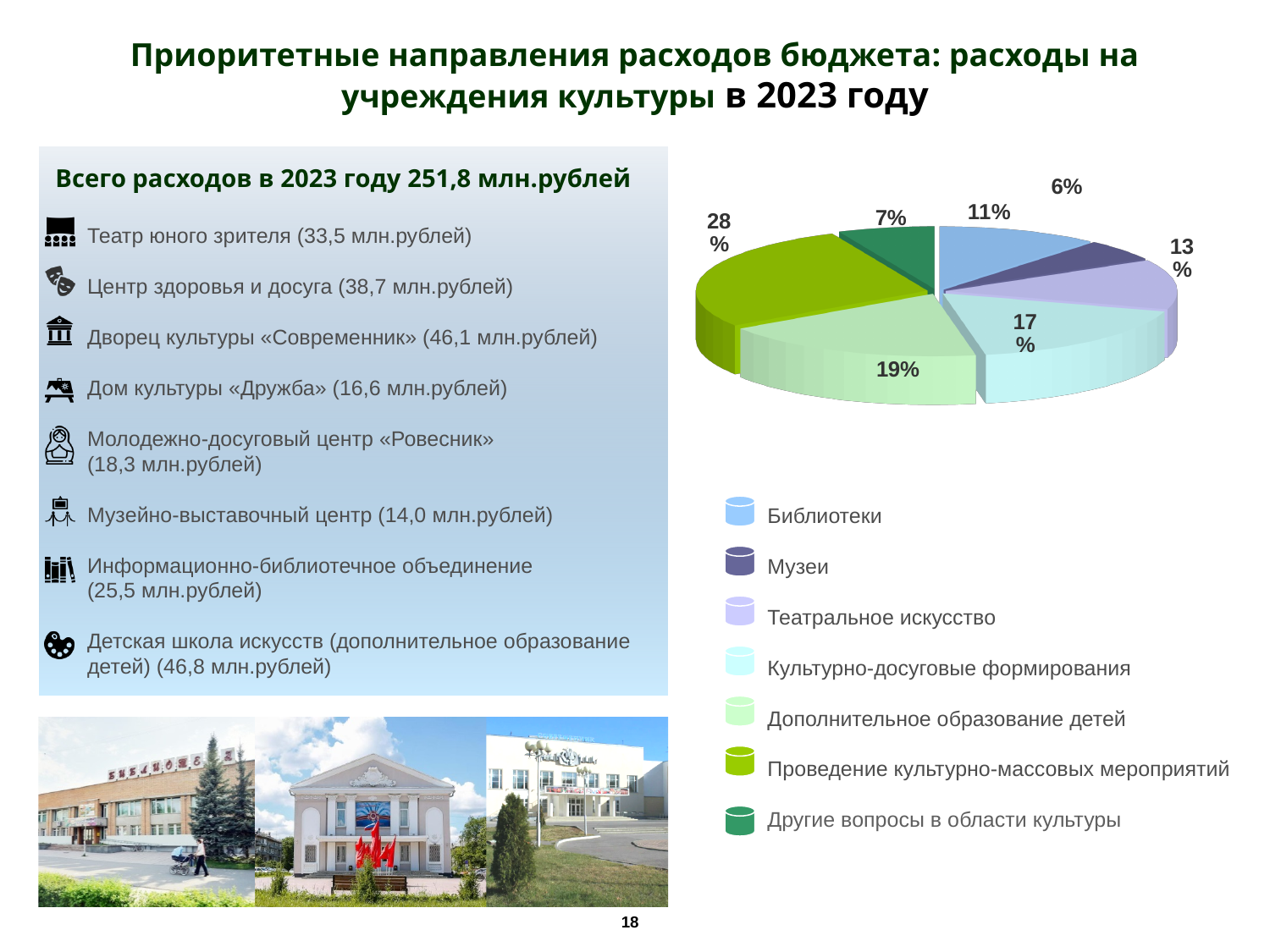
What type of chart is shown on the slide? Pie chart Which has a larger share: Библиотеки or Театральное искусство? Театральное искусство How many categories does the legend of the pie chart list? 7 What share does Театральное искусство have in the pie chart? 13% What share of the pie chart is Дополнительное образование детей? 19% Which category has the smallest slice in the pie chart? Музеи What percentage is shown for Проведение культурно-массовых мероприятий? 28% How many percentage points larger is the share of Проведение культурно-массовых мероприятий than the share of Дополнительное образование детей? 9 What percentage is shown for Культурно-досуговые формирования? 17% What share of the pie chart does Библиотеки account for? 11% Which category has the largest slice in the pie chart? Проведение культурно-массовых мероприятий What percentage is shown for Музеи in the pie chart? 6%